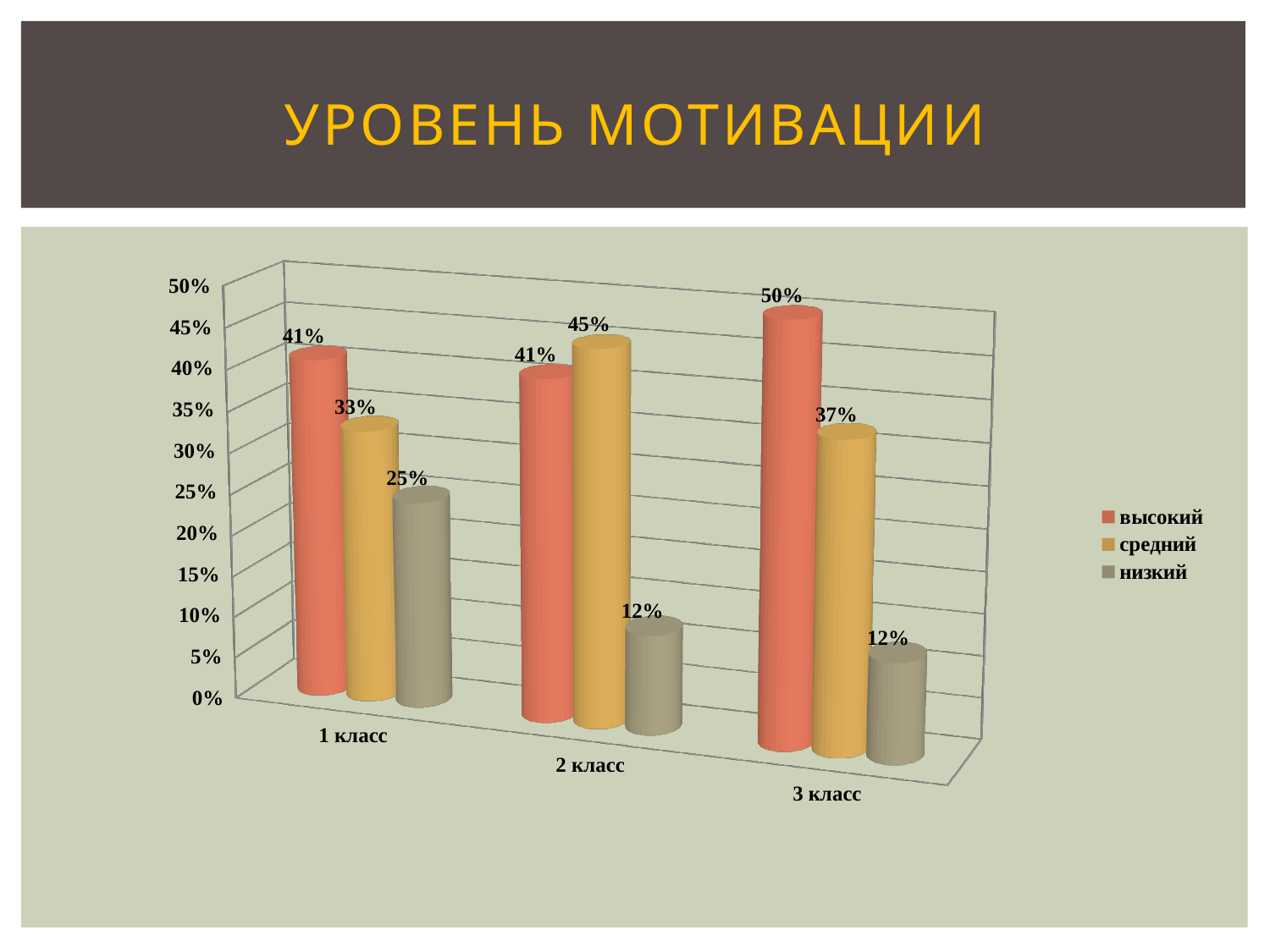
What is the difference between высокий and средний in 3 класс? 13% What kind of chart is shown on the slide? bar chart How many categories are shown on the x axis? 3 How many series does the legend list? 3 Which category has the highest value for высокий? 3 класс Does the value for низкий rise or fall from 1 класс to 3 класс? fall What is the value for средний in 2 класс? 45% What is the title of the slide? УРОВЕНЬ МОТИВАЦИИ Which is larger in 2 класс: высокий or средний? средний Which category has the lowest value for средний? 1 класс What is the value for низкий in 3 класс? 12% What is the value for высокий in 1 класс? 41%